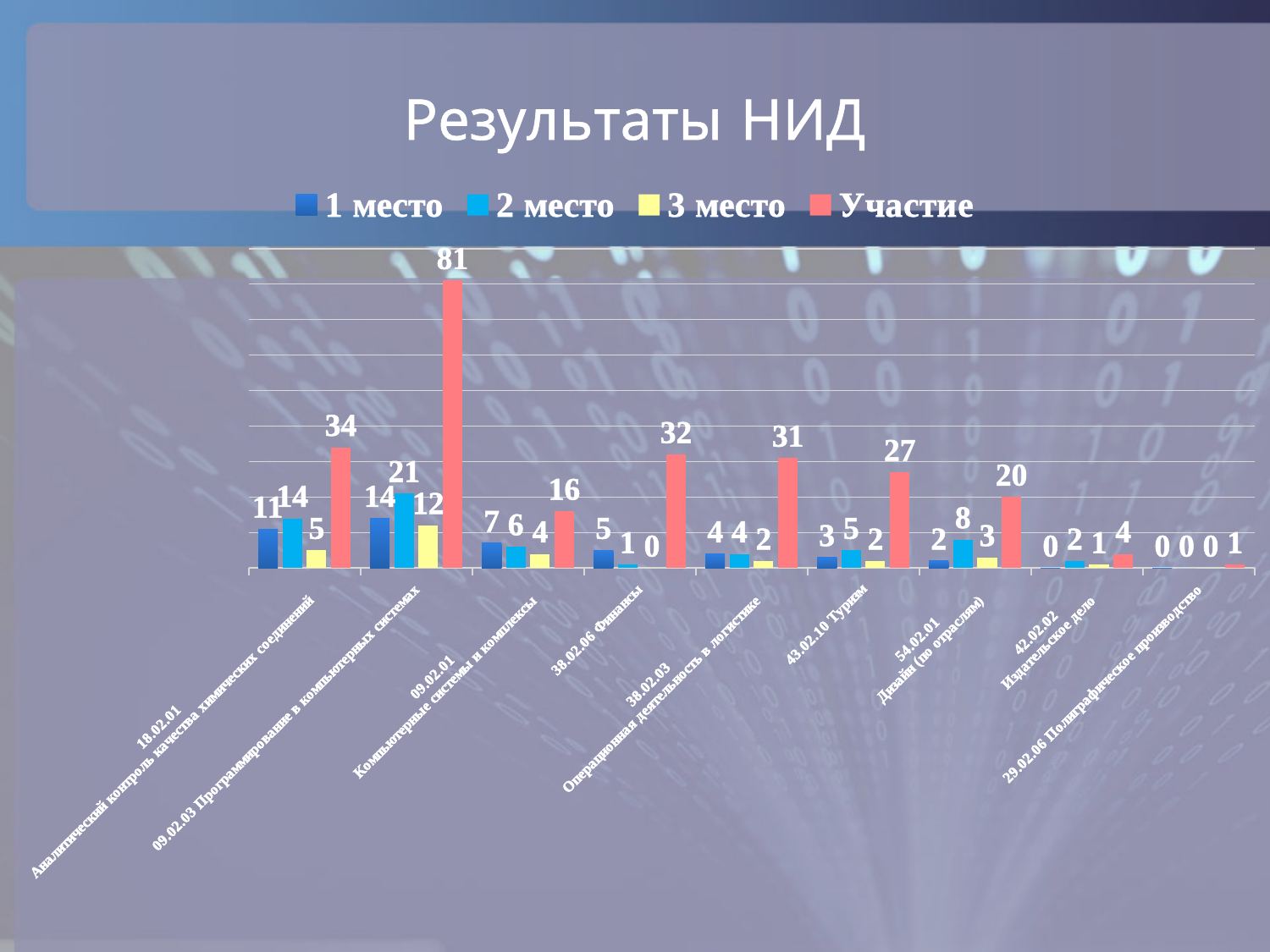
What is the value of 1 место for 18.02.01 Аналитический контроль качества химических соединений? 11 What is the total of the four values for 42.02.02 Издательское дело? 7 How many categories (specialties) are shown on the x axis? 9 What type of chart is shown on the slide? bar chart Which category has the highest Участие value? 09.02.03 Программирование в компьютерных системах What is the value of Участие for 09.02.03 Программирование в компьютерных системах? 81 What is the value of 2 место for 54.02.01 Дизайн (по отраслям)? 8 What is the difference between the Участие values for 38.02.06 Финансы and 43.02.10 Туризм? 5 Which category has the lowest Участие value? 29.02.06 Полиграфическое производство Which is larger: the 2 место value for 09.02.03 Программирование в компьютерных системах or the 2 место value for 18.02.01 Аналитический контроль качества химических соединений? 09.02.03 Программирование в компьютерных системах What is the title of the chart? Результаты НИД How many series does the legend list? 4